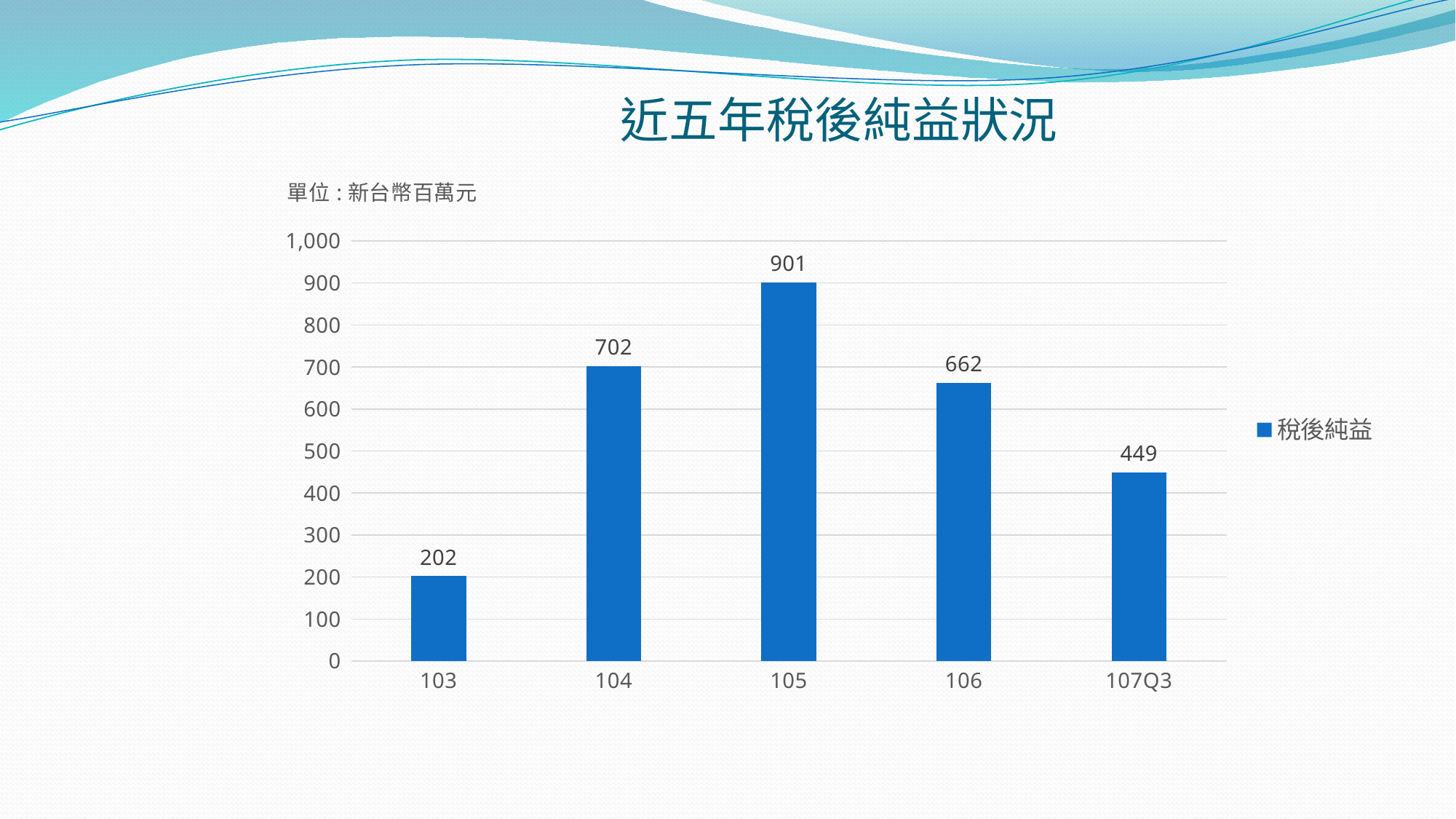
How many series does the legend list? 1 What is the value for 105? 901 What is the difference between the values for 105 and 103? 699 What is the value for 107Q3? 449 What is the difference between the values for 104 and 106? 40 Which category has the lowest value? 103 What is the title of the chart? 近五年稅後純益狀況 What kind of chart is this? bar chart What is the value for 103? 202 Which is larger, the value for 104 or the value for 106? 104 Which category has the highest value? 105 How many categories are shown on the x axis? 5